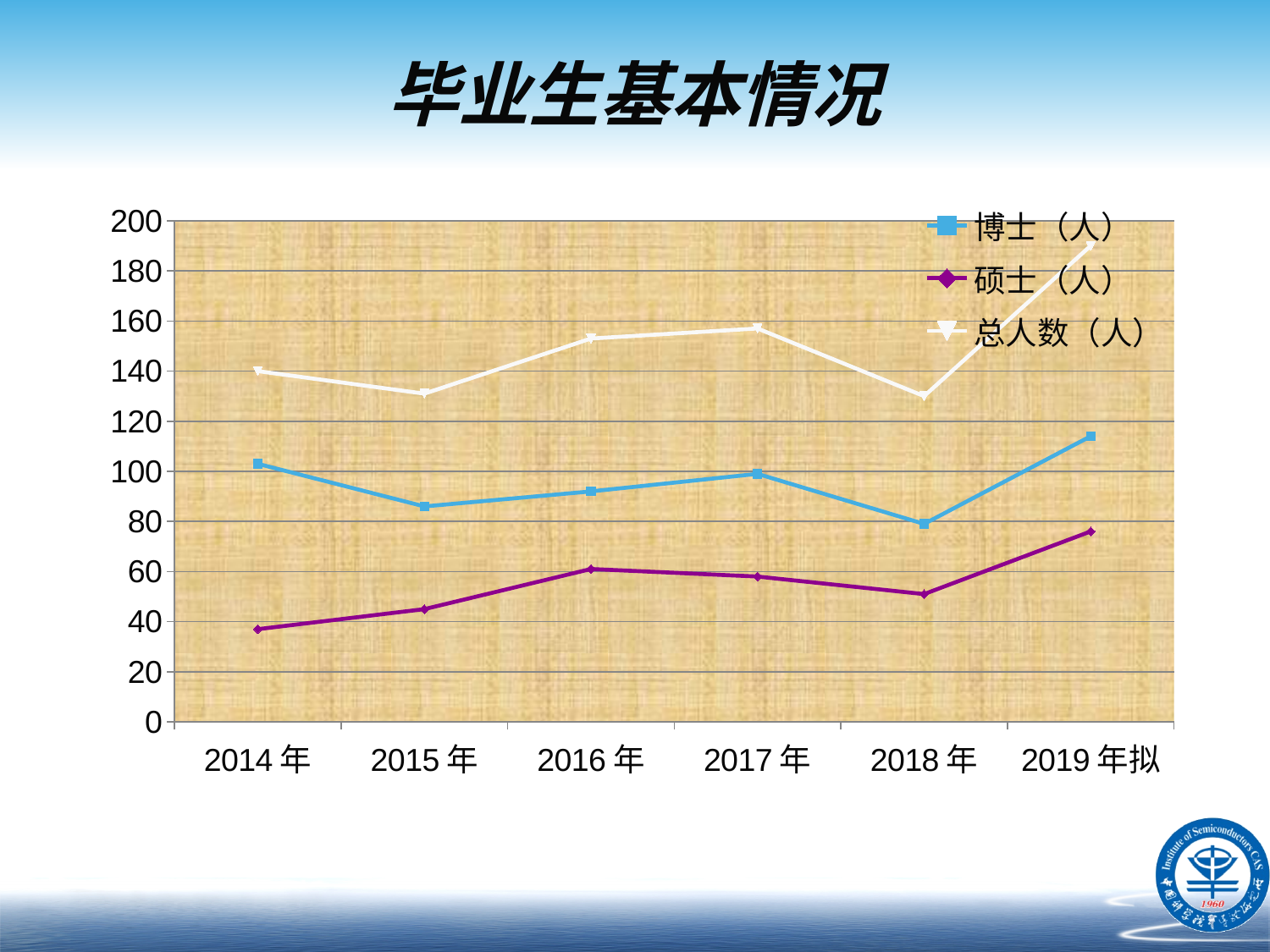
Is the value for 硕士（人） in 2019年拟 greater or less than 60? greater In which year is the value for 硕士（人） lowest? 2014年 In which year is the value for 博士（人） highest? 2019年拟 How many series does the legend list? 3 In which year is the value for 总人数（人） highest? 2019年拟 Which series is drawn with a white line? 总人数（人） What kind of chart is shown on the slide? line chart How many years are shown on the x axis? 6 Is the value for 总人数（人） in 2019年拟 greater or less than 180? greater Is the value for 总人数（人） in 2018年 greater or less than 140? less Which is larger, the value for 博士（人） in 2014年 or in 2015年? 2014年 Does the value for 硕士（人） rise or fall from 2014年 to 2016年? rise